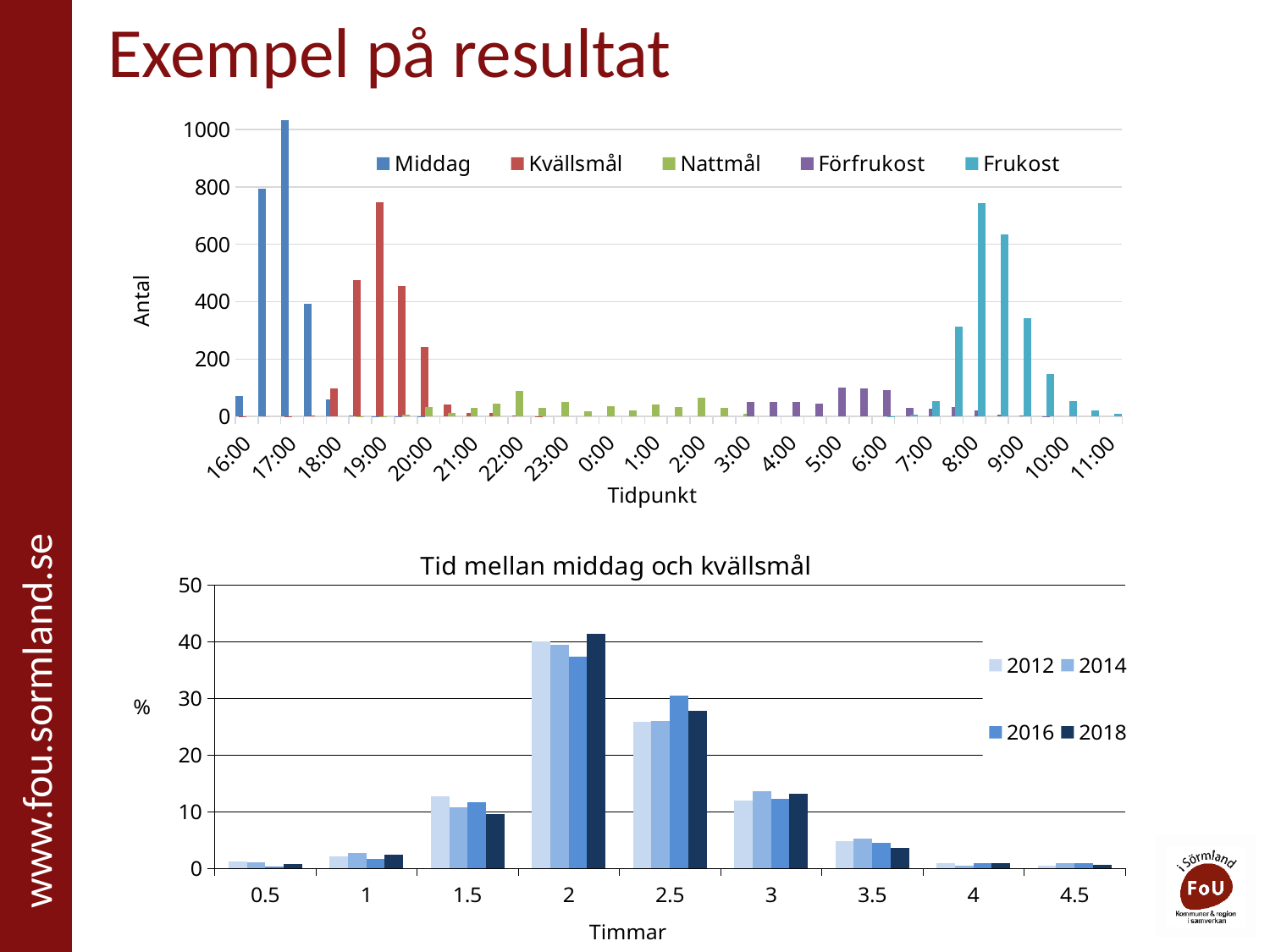
In the top chart, at which time point does the Kvällsmål series reach its highest value? 19:00 In the bottom chart 'Tid mellan middag och kvällsmål', which category has the highest value for the 2018 series? 2 In the top chart, at which time point does the Middag series reach its highest value? 17:00 How many series does the legend of the bottom chart 'Tid mellan middag och kvällsmål' list? 4 In the bottom chart 'Tid mellan middag och kvällsmål', is the 2012 value at 2.5 hours greater or less than 30? less What is the title of the bottom chart? Tid mellan middag och kvällsmål How many series does the legend of the top chart list? 5 What is the x-axis label of the top chart? Tidpunkt What kind of chart is the top chart on the slide? bar chart In the top chart, is the Frukost value at 8:00 greater or less than 600? greater In the top chart, is the Middag value at 17:00 greater or less than 800? greater How many categories are shown on the x axis of the bottom chart 'Tid mellan middag och kvällsmål'? 9